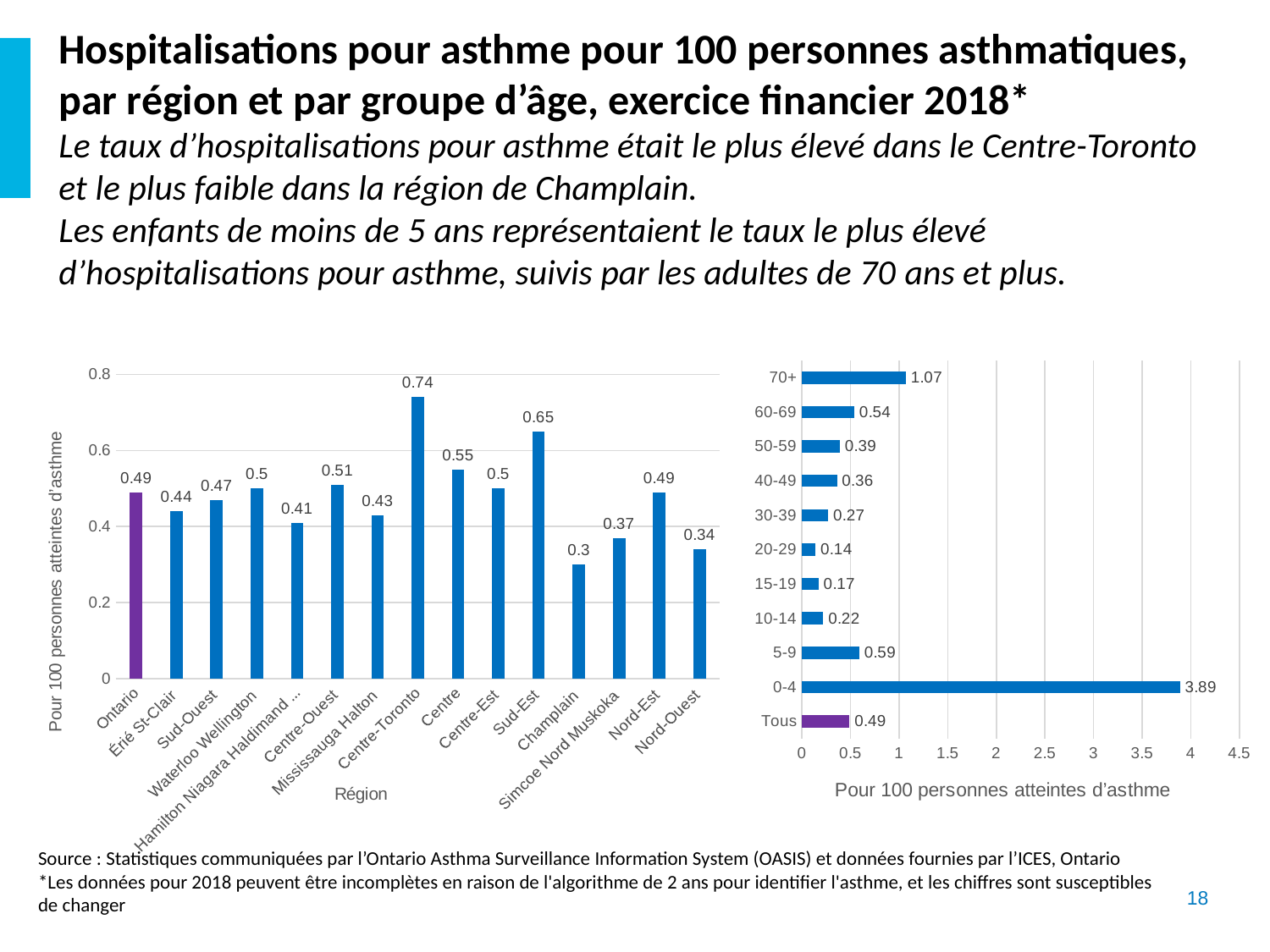
In the left chart (by region), what is the difference between Centre-Toronto and Champlain? 0.44 In the left chart (by region), what is the label of the x axis? Région In the left chart (by region), which region has the lowest value? Champlain In the left chart (by region), what is the value for Simcoe Nord Muskoka? 0.37 In the left chart (by region), how many regions are shown on the x axis? 15 In the left chart (by region), what is the value for Centre-Toronto? 0.74 In the right chart (by age group), which age group has the lowest value? 20-29 What type of chart is the right chart (by age group)? Bar chart In the right chart (by age group), what is the value for the 0-4 age group? 3.89 In the right chart (by age group), how many bars are shown? 11 In the left chart (by region), which is larger, Sud-Est or Centre? Sud-Est In the right chart (by age group), what is the difference between the 70+ and 60-69 age groups? 0.53